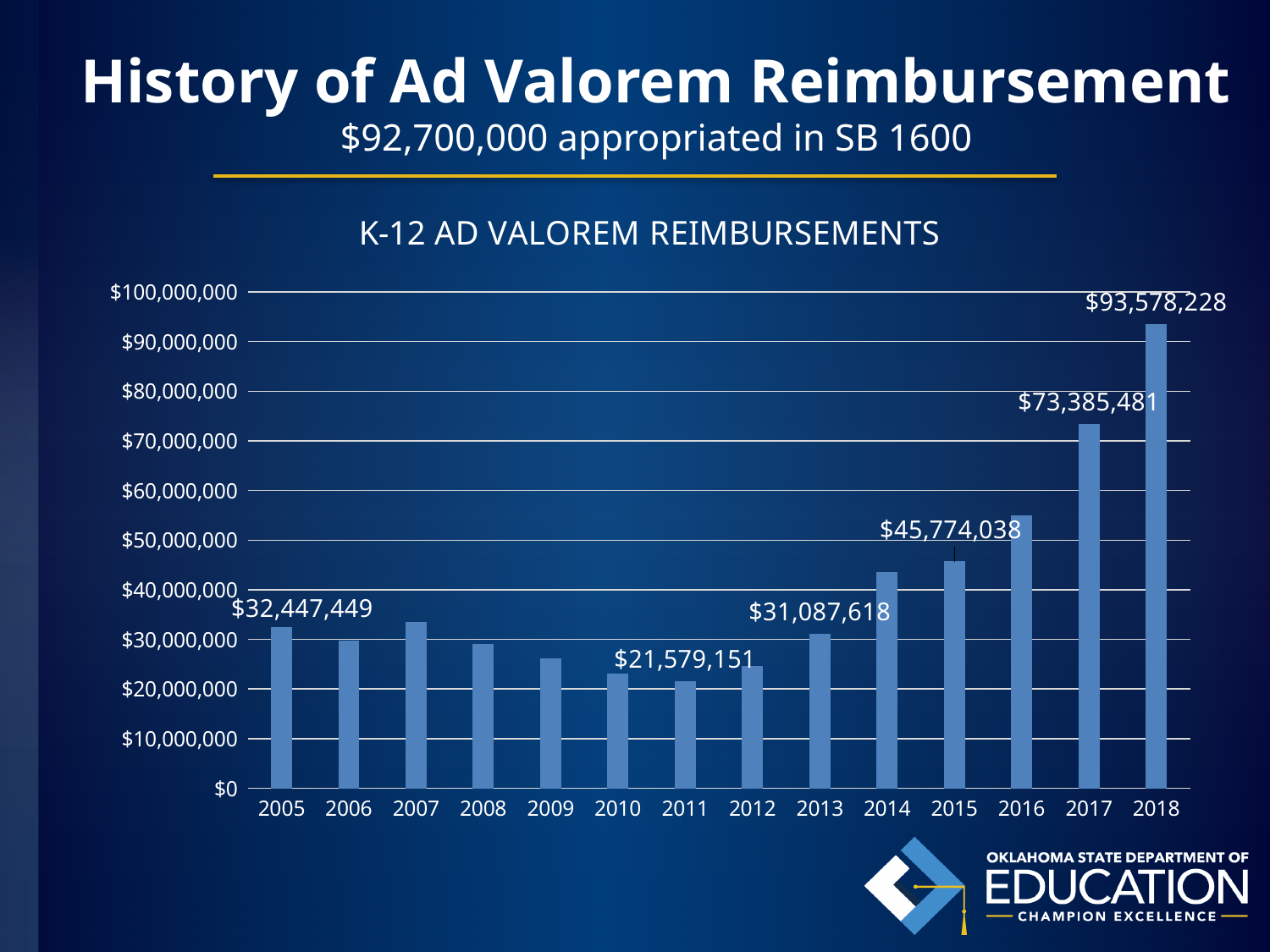
What is the value for 2005? $32,447,449 What is the title of the chart? K-12 AD VALOREM REIMBURSEMENTS How many years are shown on the x axis? 14 What is the value for 2015? $45,774,038 What is the difference between the 2018 and 2017 values? $20,192,747 What is the value for 2017? $73,385,481 Which is larger, the value for 2005 or the value for 2013? 2005 Which year has the highest reimbursement? 2018 What kind of chart is shown? bar chart What is the value for 2018? $93,578,228 Is the value for 2009 greater or less than $30,000,000? less Is the value for 2016 greater or less than $50,000,000? greater